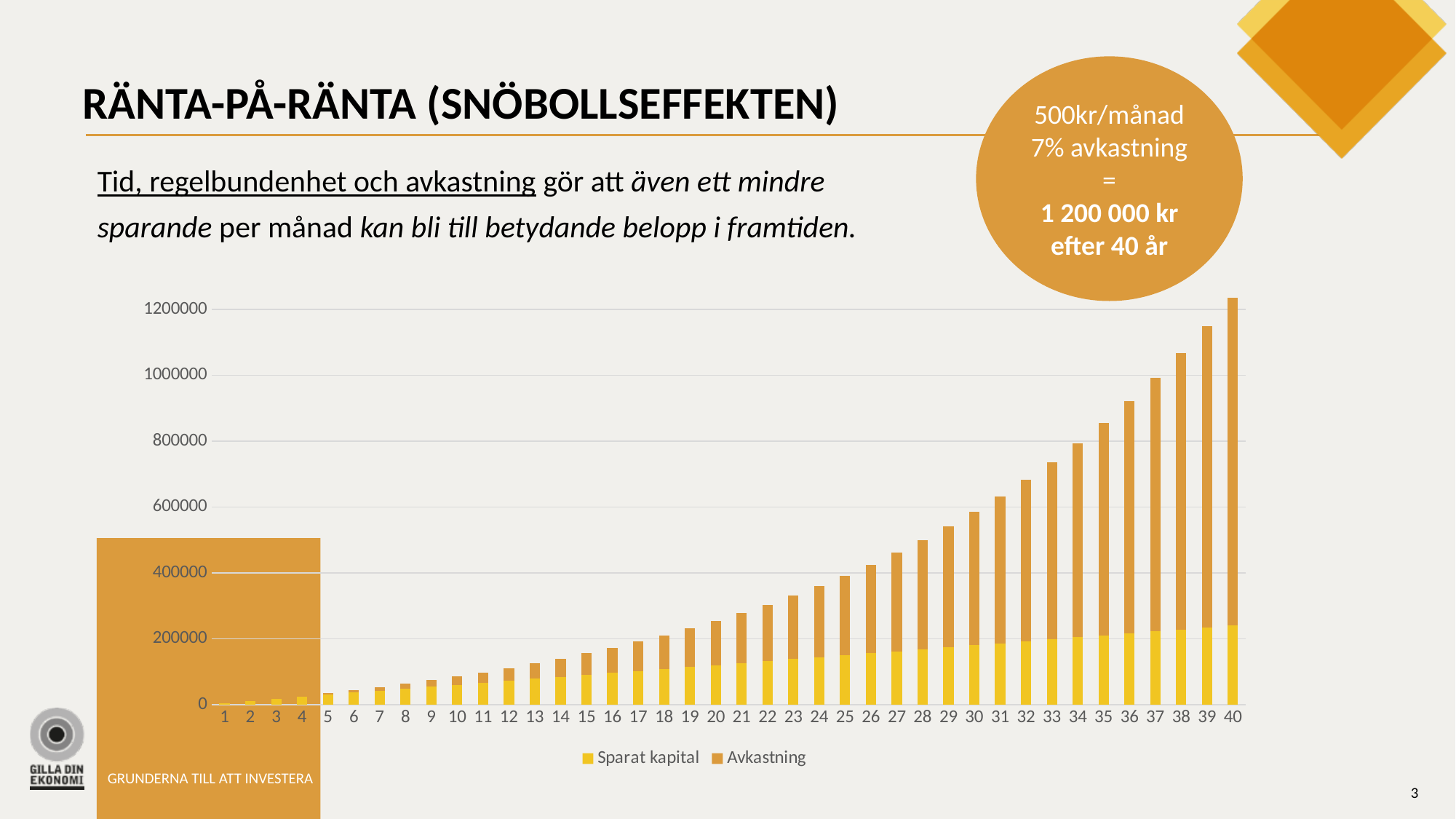
What are the two series named in the chart legend? Sparat kapital and Avkastning Which is larger, the total bar for year 25 or the total bar for year 15? Year 25 Do the total bar values rise or fall as the years increase along the x axis? Rise Is the total value for year 38 greater or less than 1000000? greater What kind of chart is shown on the slide? Bar chart How many categories (years) are shown along the x axis of the chart? 40 Which year has the highest total bar in the chart? 40 How many series does the chart legend list? 2 Which year has the lowest total bar in the chart? 1 Is the total value for year 10 greater or less than 200000? less Is the total value for year 20 greater or less than 200000? greater